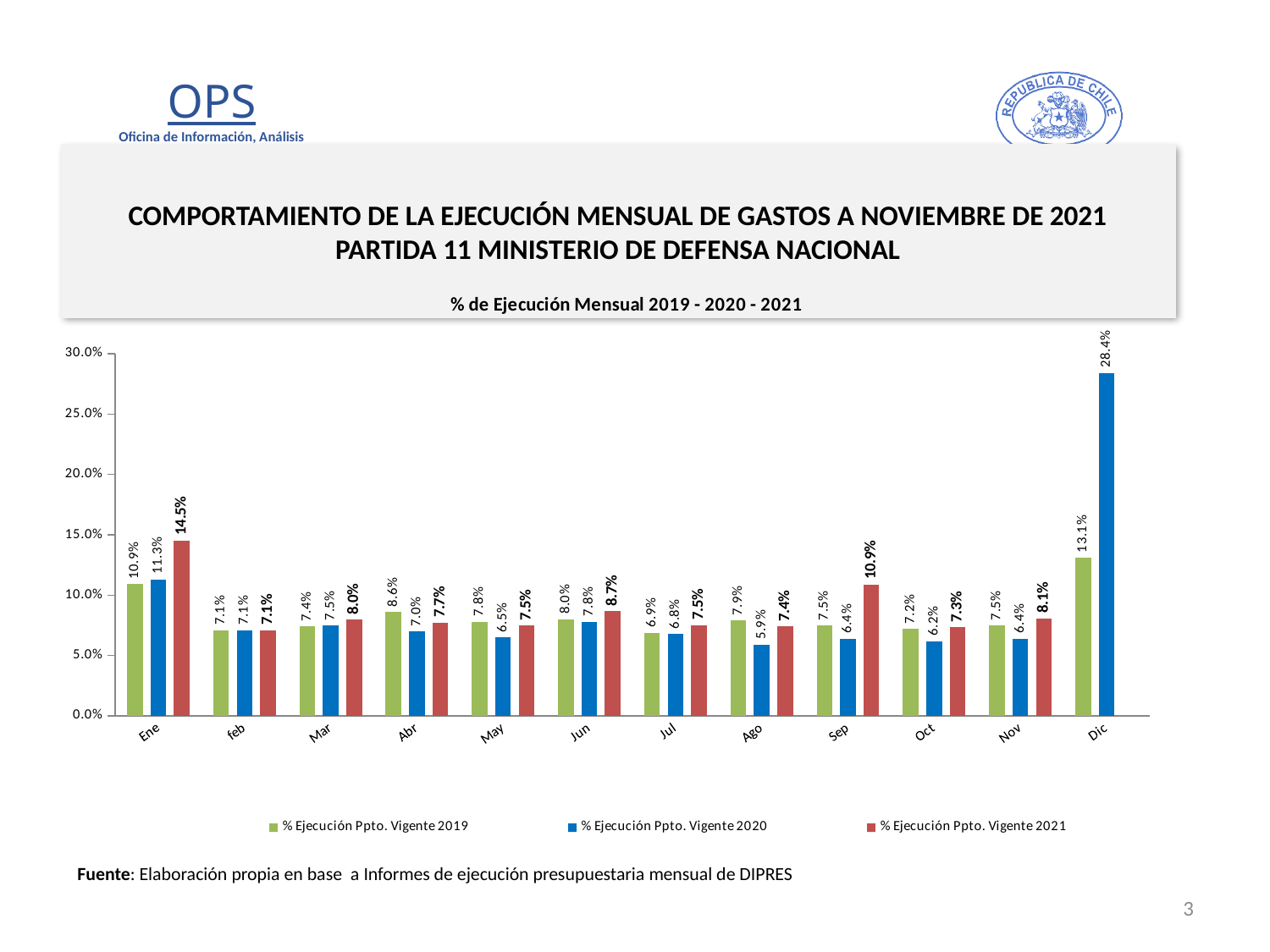
What is the value for % Ejecución Ppto. Vigente 2019 in Abr? 8.6% What kind of chart is shown on the slide? Bar chart What is the value for % Ejecución Ppto. Vigente 2021 in Ene? 14.5% How many months are shown on the x axis? 12 What is the value for % Ejecución Ppto. Vigente 2021 in Sep? 10.9% What is the difference between the 2020 and 2019 values in Dic? 15.3% Which month has the highest value for % Ejecución Ppto. Vigente 2020? Dic What is the value for % Ejecución Ppto. Vigente 2020 in Dic? 28.4% Which is larger in Ago: the 2019 value or the 2020 value? 2019 Which month has the lowest value for % Ejecución Ppto. Vigente 2020? Ago Is the value for % Ejecución Ppto. Vigente 2020 in Dic greater or less than 25.0%? greater How many series does the legend list? 3